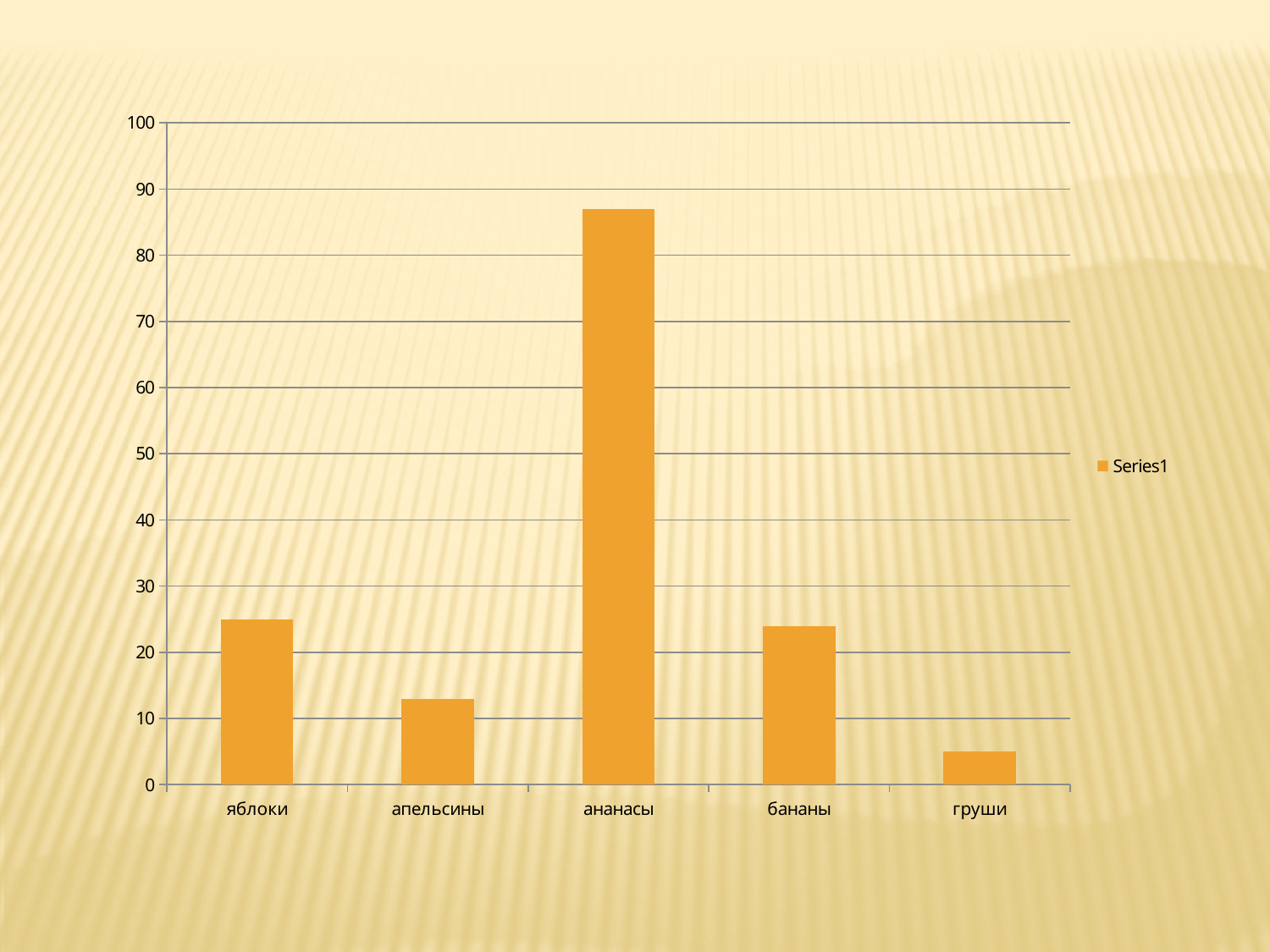
How many series does the legend list? 1 Is the value for бананы greater or less than 30? less What kind of chart is shown on the slide? bar chart Is the value for апельсины greater or less than 20? less Which category has the lowest value? груши Is the value for ананасы greater or less than 80? greater What is the name of the series shown in the legend? Series1 Which is larger, the value for апельсины or the value for бананы? бананы How many categories are shown on the x axis? 5 Which category has the highest value? ананасы